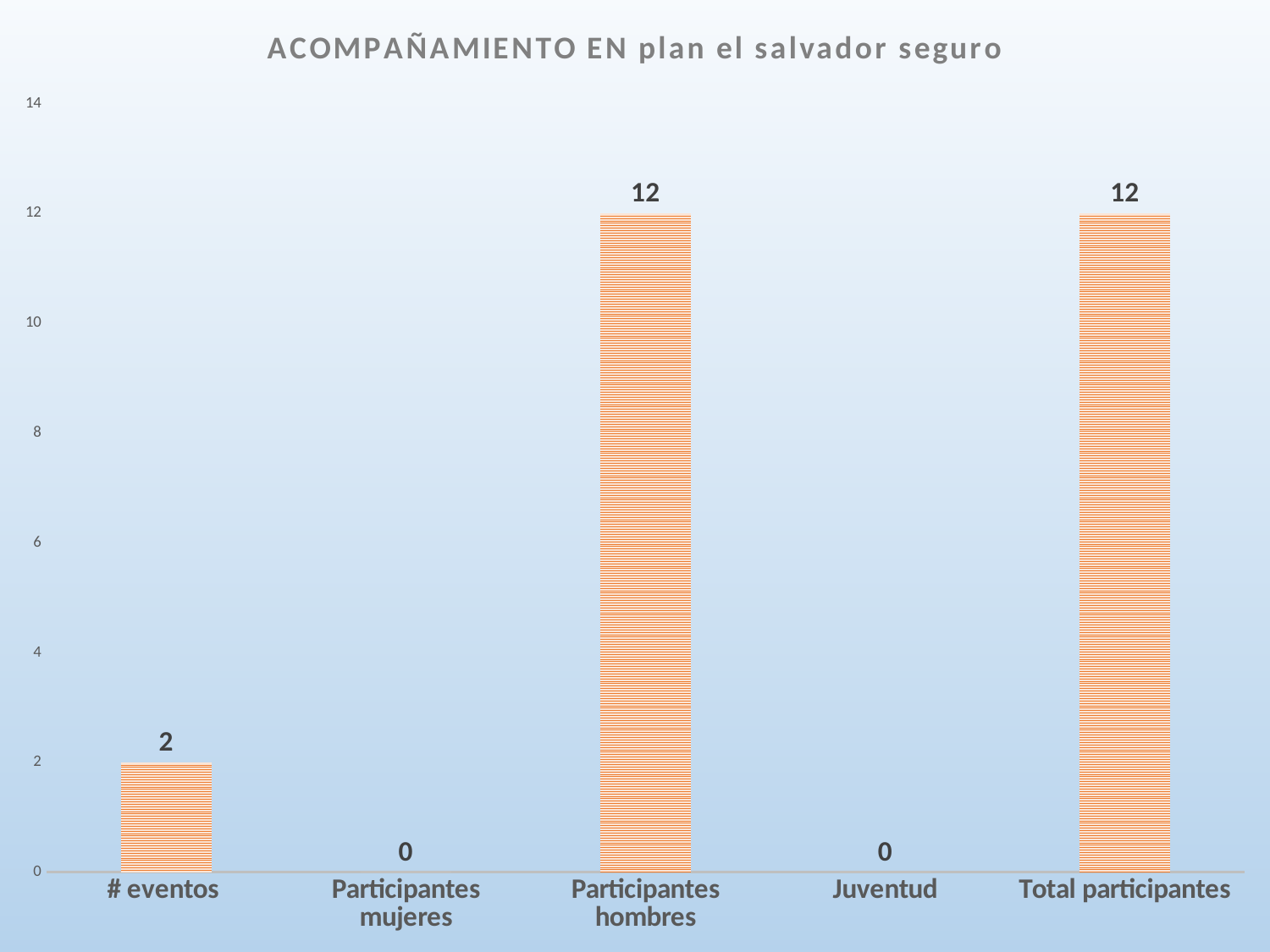
Is the value for Participantes hombres greater or less than 10? greater What is the value for Participantes hombres? 12 What is the value for Total participantes? 12 How many categories have a value of 0? 2 Which is larger, # eventos or Participantes hombres? Participantes hombres What is the value for Juventud? 0 What is the value for Participantes mujeres? 0 How many categories are shown on the x axis? 5 What is the difference between Participantes hombres and # eventos? 10 What is the title of the chart? ACOMPAÑAMIENTO EN plan el salvador seguro What is the value for # eventos? 2 What kind of chart is this? bar chart